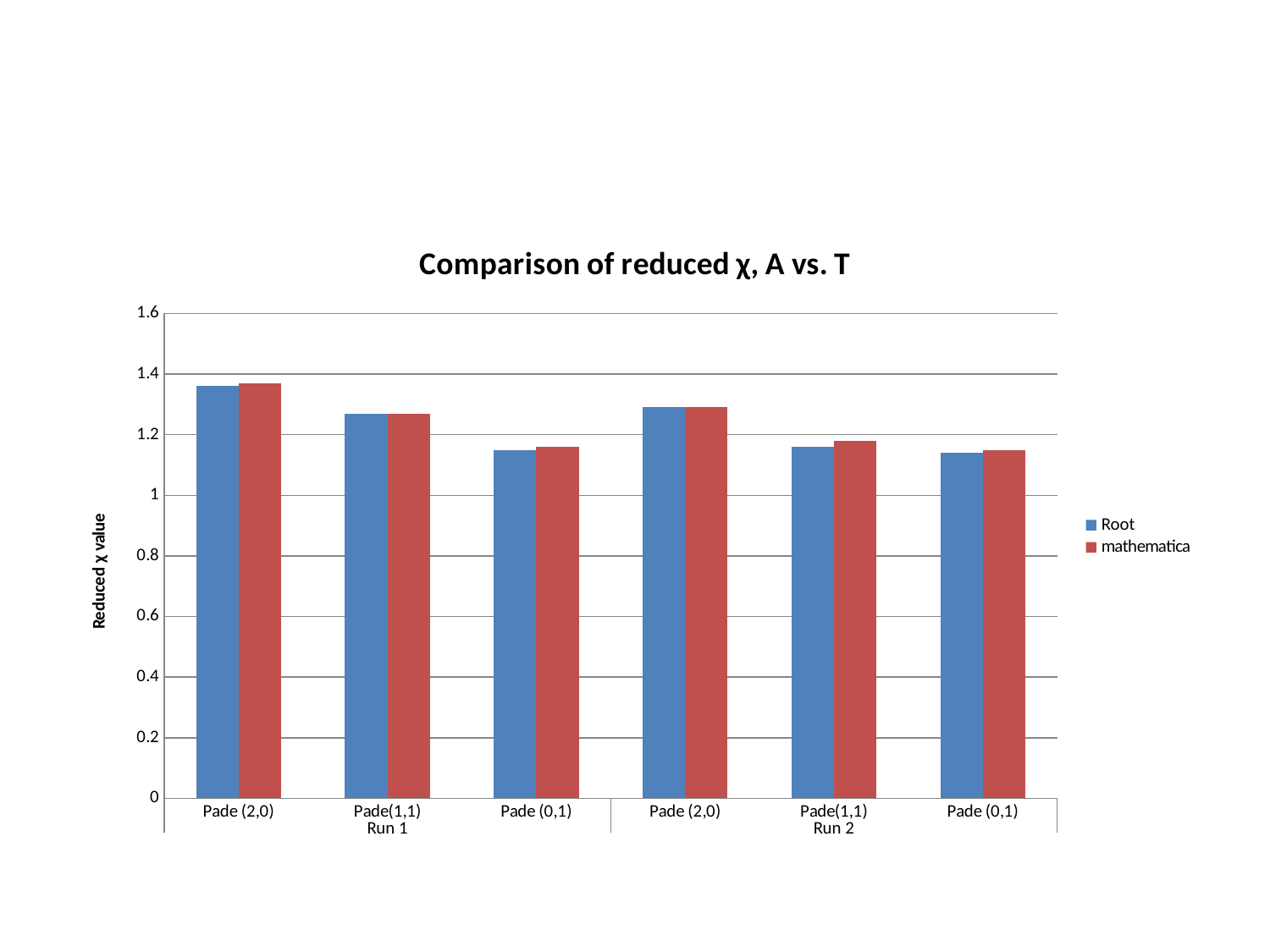
How many category groups are shown along the x axis? 6 Which category has the highest mathematica value? Pade (2,0) in Run 1 How many series does the legend list? 2 Which category has the highest Root value? Pade (2,0) in Run 1 Is the mathematica value for Pade (2,0) in Run 2 greater or less than 1.4? less Within Run 1, do the Root values rise or fall from Pade (2,0) to Pade (0,1)? fall Which is larger, the Root value for Pade(1,1) in Run 1 or the Root value for Pade(1,1) in Run 2? Pade(1,1) in Run 1 What are the two series named in the legend? Root and mathematica Is the Root value for Pade (0,1) in Run 1 greater or less than 1.2? less What kind of chart is shown on the slide? bar chart Is the Root value for Pade (2,0) in Run 1 greater or less than 1.2? greater What is the title of the chart? Comparison of reduced χ, A vs. T